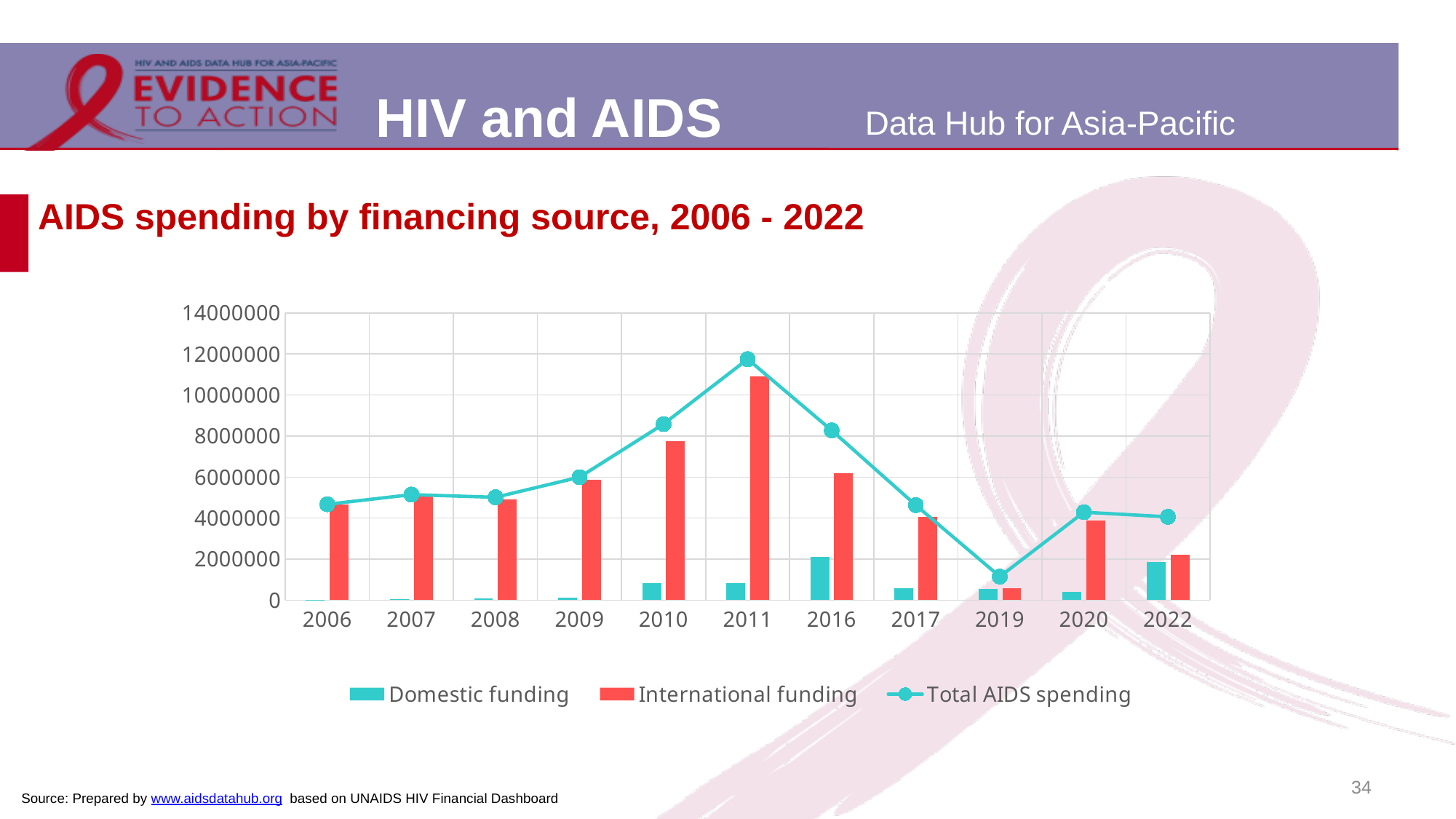
What is the title of the chart? AIDS spending by financing source, 2006 - 2022 In which year is Total AIDS spending lowest? 2019 Is International funding in 2011 greater or less than 10000000? greater Does Total AIDS spending rise or fall from 2011 to 2019? fall In which year is International funding highest? 2011 Is Total AIDS spending in 2010 greater or less than 8000000? greater How many years are shown on the x axis? 11 What kind of chart is shown on the slide? A combined bar and line chart Is Total AIDS spending in 2019 greater or less than 2000000? less Which is larger, International funding in 2010 or in 2011? 2011 How many series does the legend list? 3 In which year is Total AIDS spending highest? 2011